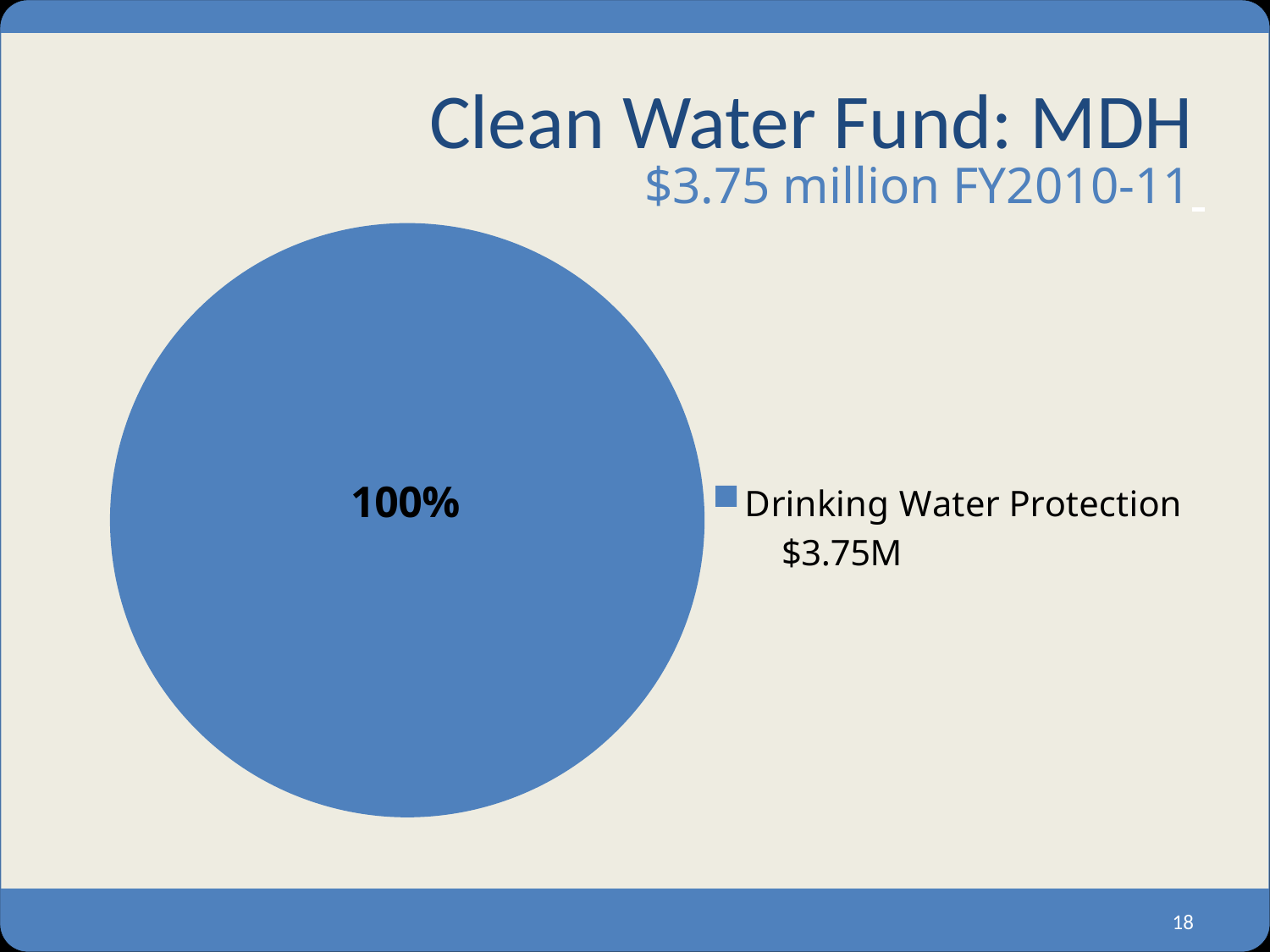
What percentage share does the Drinking Water Protection slice have in the pie chart? 100% How many entries does the legend of the pie chart list? 1 What kind of chart is shown on the slide? pie chart What total amount and fiscal years are given in the chart's subtitle? $3.75 million FY2010-11 What is the title of the chart on the slide? Clean Water Fund: MDH How many slices does the pie chart have? 1 What dollar amount is shown in the legend for Drinking Water Protection? $3.75M